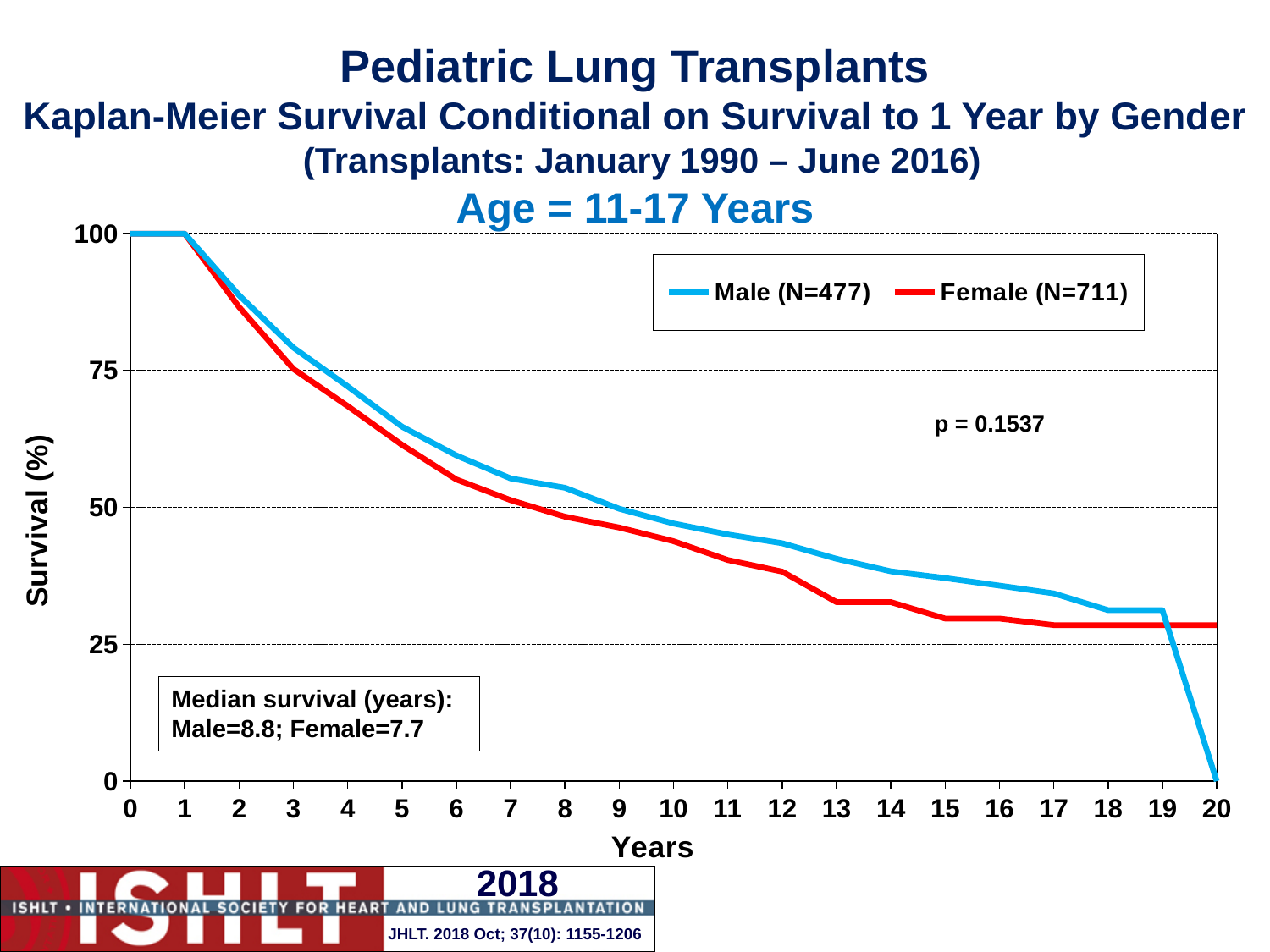
How many series does the legend list? 2 What is the median survival in years for females? 7.7 What is the sample size (N) for the Female series? 711 What is the median survival in years for males? 8.8 Is the Female survival at 15 years greater or less than 25%? greater What kind of chart is shown on the slide? Line chart Do the survival curves rise or fall as years increase? Fall What p-value is shown on the chart? p = 0.1537 What is the difference between the male and female median survival in years? 1.1 What is the sample size (N) for the Male series? 477 Is the Male survival at 12 years greater or less than 50%? less Which gender has the higher median survival? Male